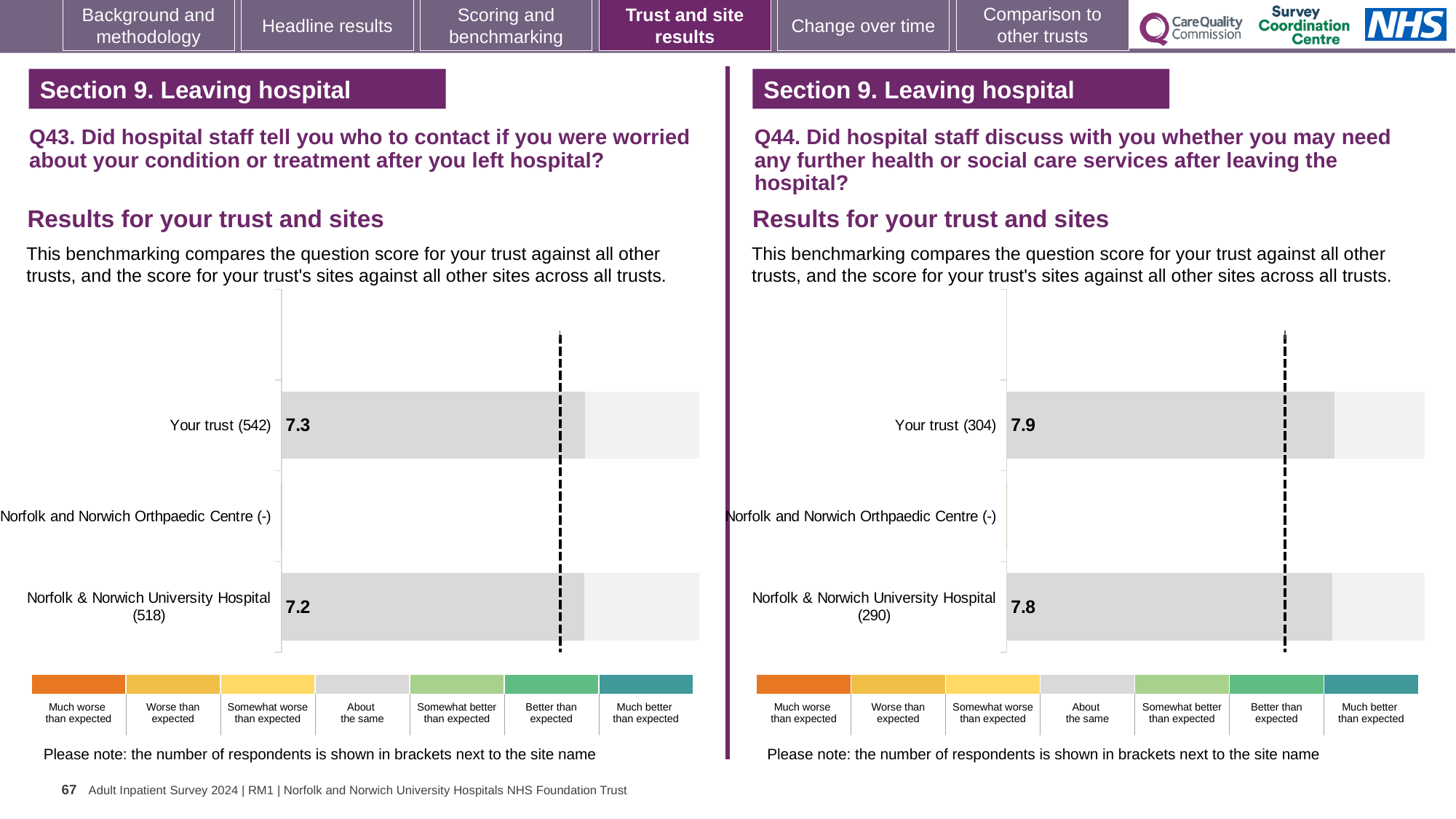
In the Q44 chart on the right, which has the higher score, Your trust or Norfolk & Norwich University Hospital? Your trust In the Q43 chart on the left, what is the score for Your trust? 7.3 In the Q44 chart on the right, how many respondents are shown in brackets for Norfolk & Norwich University Hospital? 290 In the Q43 chart on the left, how many respondents are shown in brackets for Your trust? 542 In the Q43 chart on the left, what is the difference between the score for Your trust and the score for Norfolk & Norwich University Hospital? 0.1 How many site/trust categories are listed on the y axis of the Q43 chart on the left? 3 What kind of chart is used for the Q44 results on the right? Bar chart In the Q44 chart on the right, what is the difference between the score for Your trust and the score for Norfolk & Norwich University Hospital? 0.1 In the Q44 chart on the right, what is the score for Your trust? 7.9 In the Q44 chart on the right, what is the score for Norfolk & Norwich University Hospital? 7.8 In the Q43 chart on the left, which has the higher score, Your trust or Norfolk & Norwich University Hospital? Your trust In the Q43 chart on the left, what is the score for Norfolk & Norwich University Hospital? 7.2